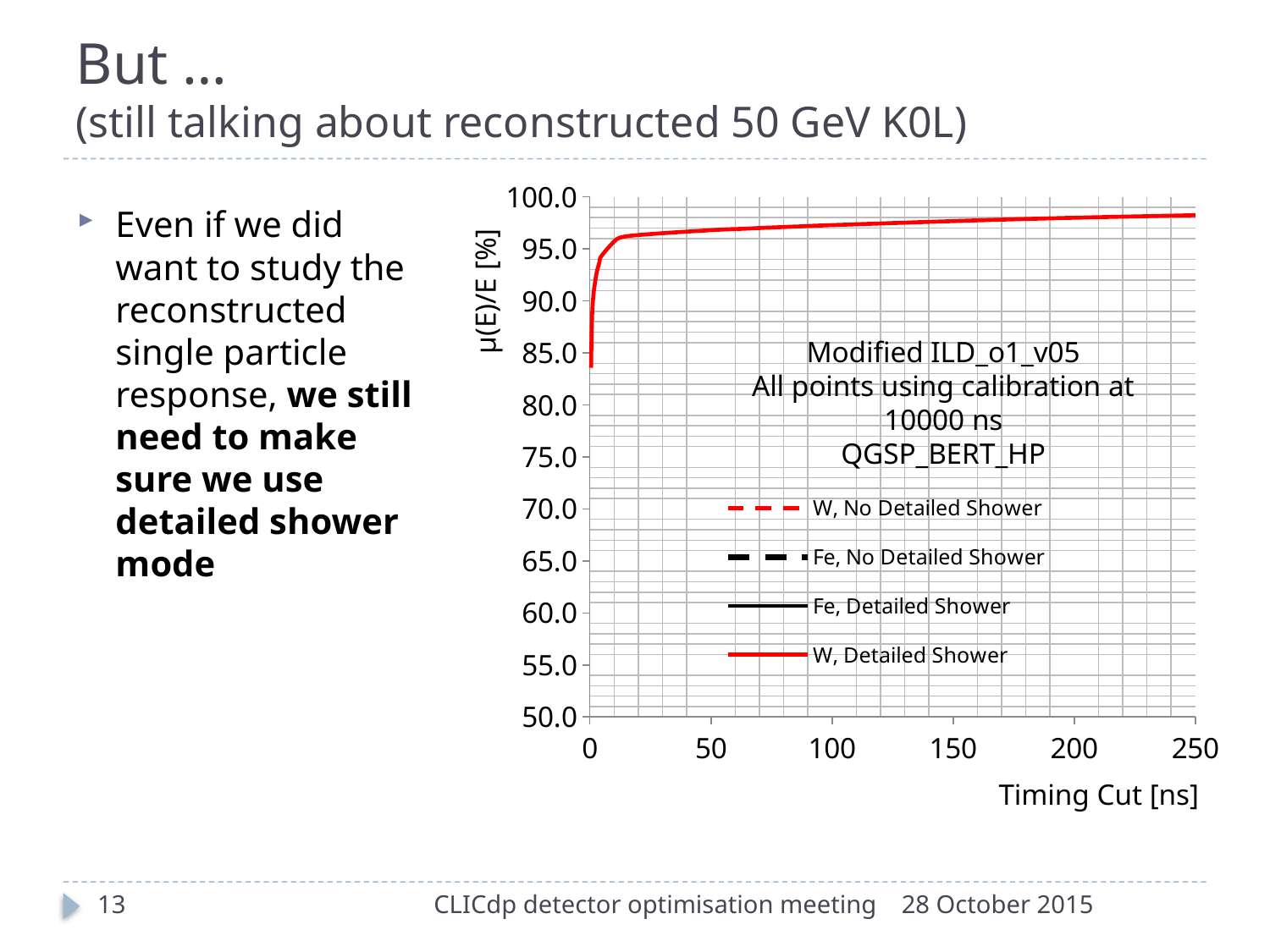
How many series does the legend list? 4 Is the value of the W, Detailed Shower curve at a timing cut of 100 ns greater or less than 95.0? greater What kind of chart is shown on the slide? line chart Is the value of the W, Detailed Shower curve at a timing cut of 250 ns greater or less than 95.0? greater What is the label of the x axis? Timing Cut [ns] What is the label of the y axis? μ(E)/E [%] Does the plotted curve rise or fall as the timing cut increases? rise Is the value of the W, Detailed Shower curve at a timing cut of 200 ns greater or less than 90.0? greater What is the maximum value shown on the x axis? 250